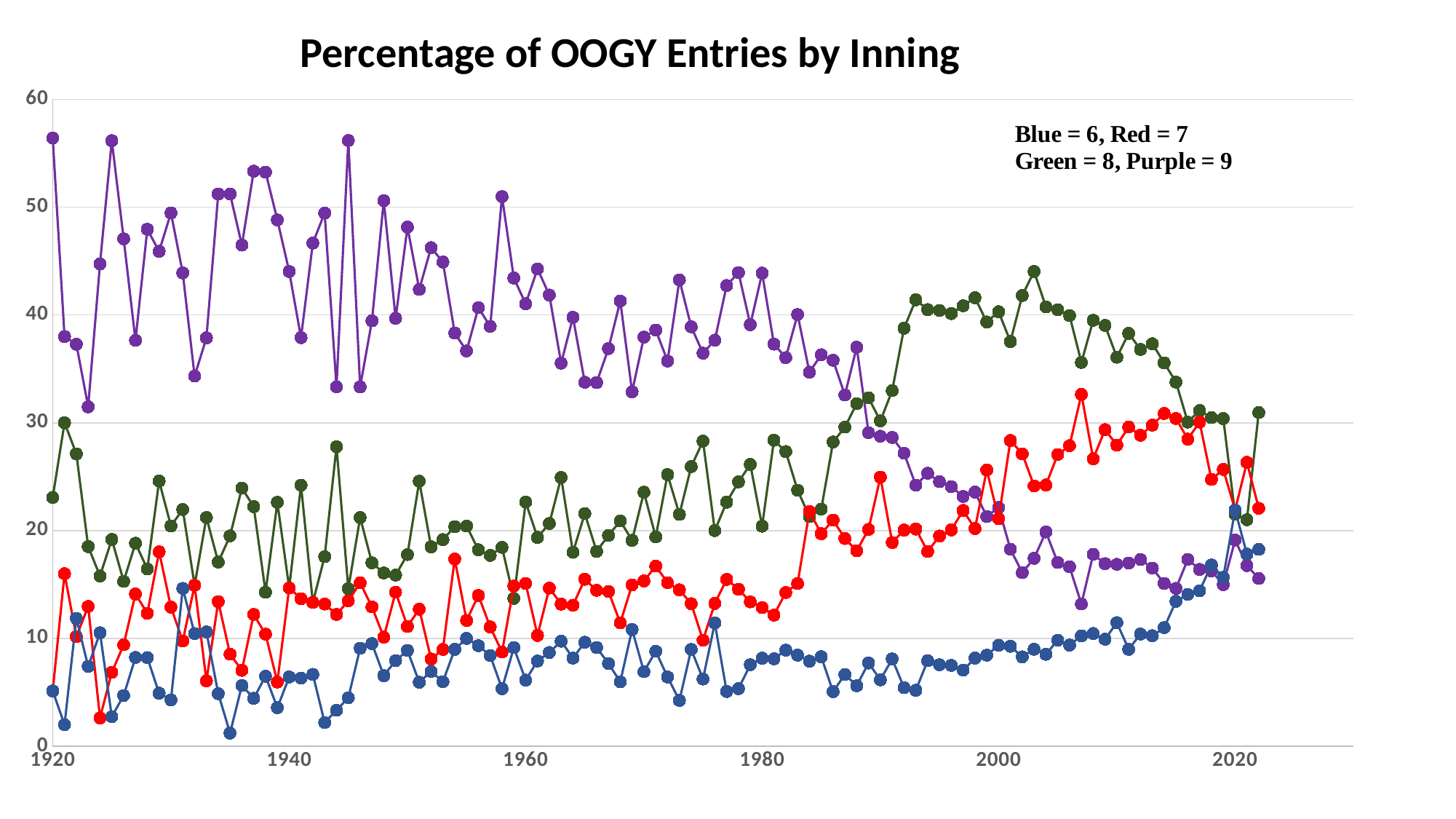
Is the purple value in 1920 greater or less than 50? greater What is the title of the chart? Percentage of OOGY Entries by Inning In 1920, which is larger, the purple value or the green value? purple Is the blue value in 1920 greater or less than 10? less What kind of chart is shown on the slide? line chart How many series are plotted on the chart? 4 Is the blue value in 1980 greater or less than 10? less Does the purple line generally rise or fall from 1920 to 2020? fall Does the blue line generally rise or fall from 1920 to 2020? rise Which series has the highest value in 1920? purple Which inning does the purple line represent? 9